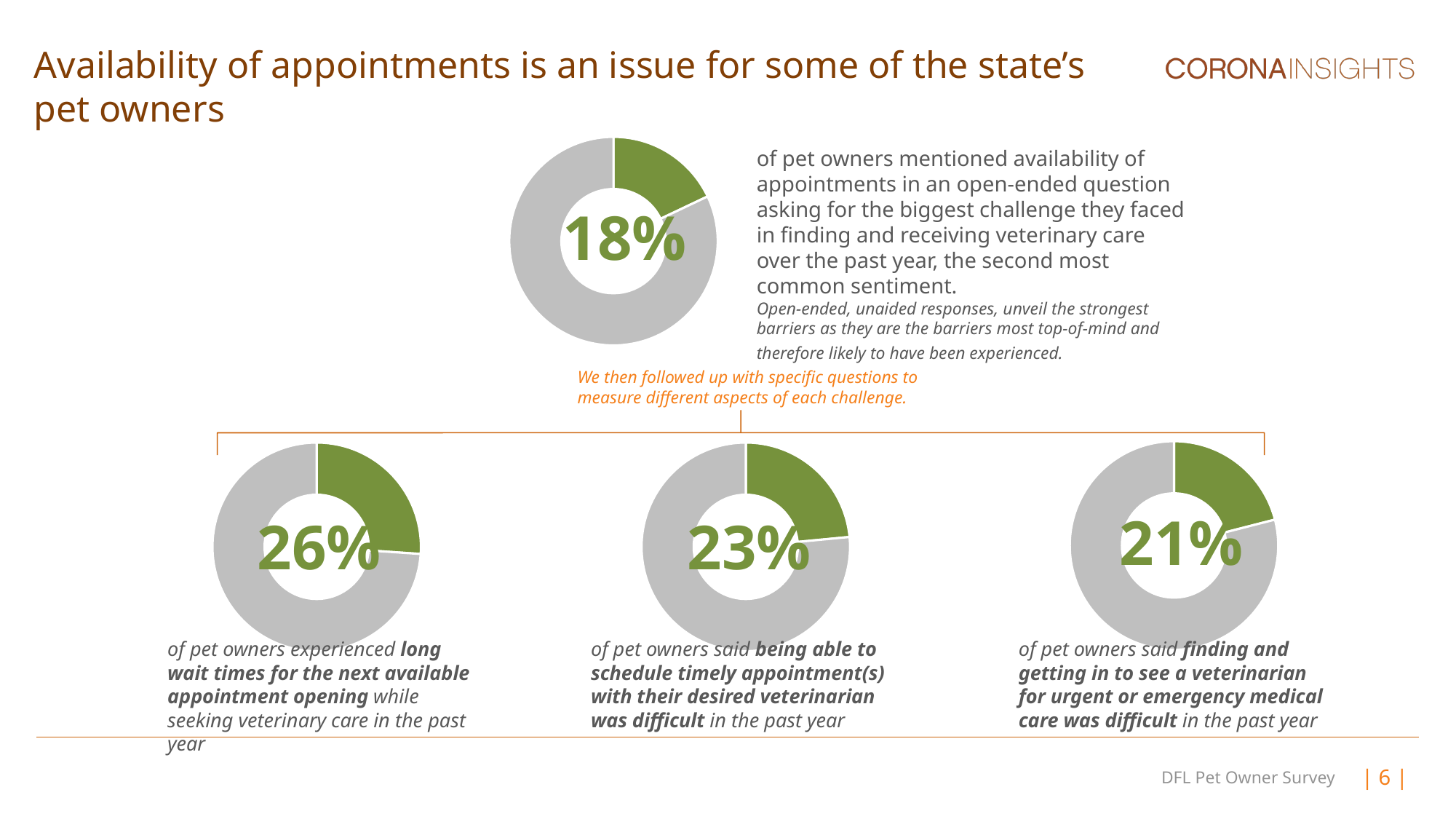
In the bottom-right donut chart, what percentage of pet owners said finding and getting in to see a veterinarian for urgent or emergency care was difficult? 21% How many donut charts are shown on the slide? 4 What type of chart is used to display the percentages on this slide? Donut (pie) chart What colour is used for the highlighted slice in each donut chart? Green Which of the three bottom donut charts shows the lowest percentage? The bottom-right chart (21%) Which is larger: the percentage in the top donut chart (18%) or the percentage in the bottom-middle donut chart (23%)? The bottom-middle chart (23%) What percentage is shown in the top donut chart about pet owners mentioning availability of appointments in an open-ended question? 18% What is the difference between the percentage in the bottom-left donut chart and the top donut chart? 8 percentage points In the bottom-left donut chart, what percentage of pet owners experienced long wait times for the next available appointment opening? 26% Which of the three bottom donut charts shows the highest percentage? The bottom-left chart (26%) What is the difference between the percentage in the bottom-left donut chart (long wait times) and the bottom-right donut chart (urgent or emergency care)? 5 percentage points In the bottom-middle donut chart, what percentage of pet owners said being able to schedule timely appointments with their desired veterinarian was difficult? 23%